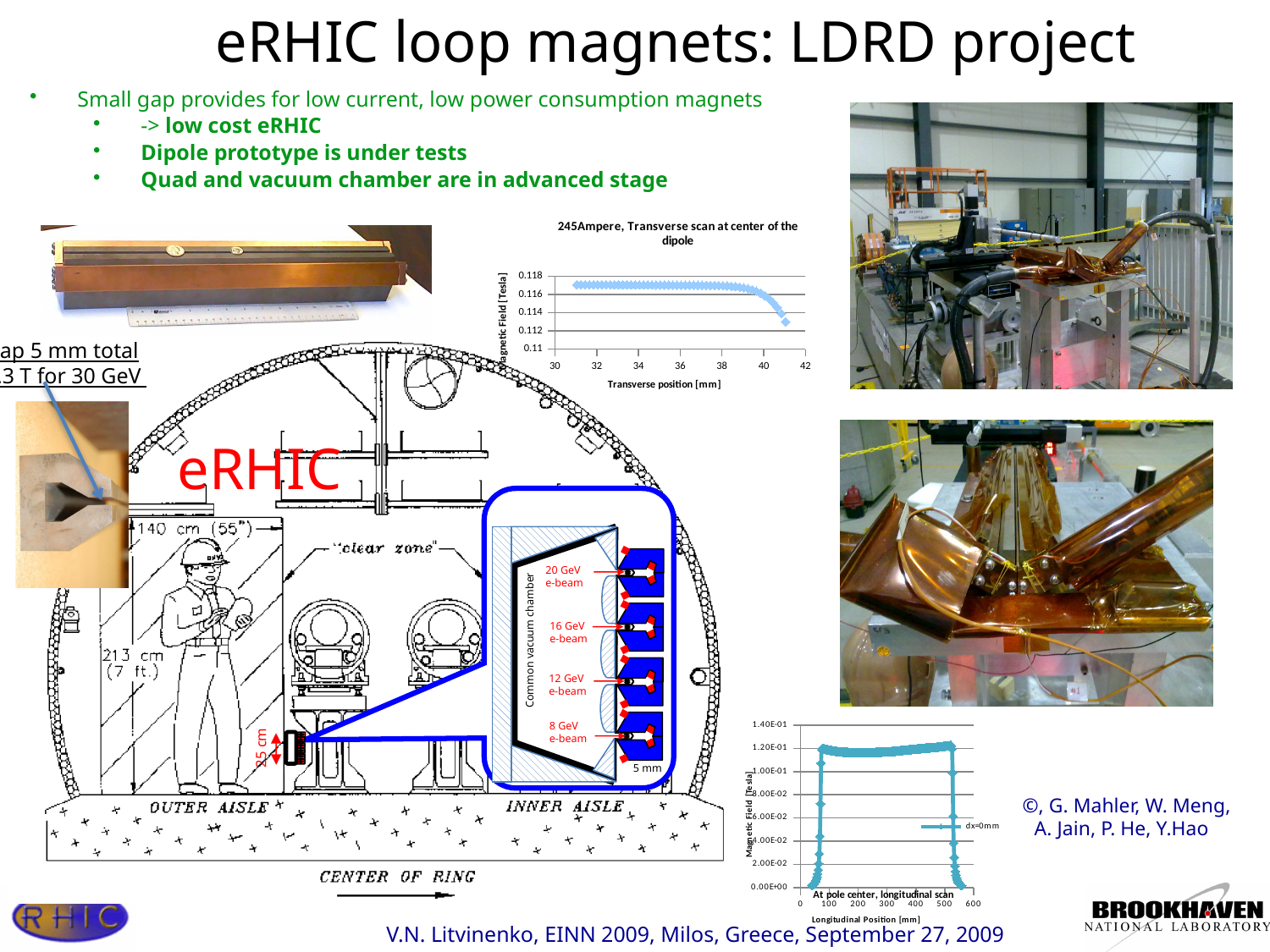
In the longitudinal scan chart at the bottom right of the slide, is the magnetic field at longitudinal position 300 mm greater or less than 1.40E-01 Tesla? less In the longitudinal scan chart at the bottom right of the slide, is the magnetic field at longitudinal position 300 mm greater or less than 1.00E-01 Tesla? greater In the longitudinal scan chart at the bottom right of the slide, what is the legend entry? dx=0mm In the chart titled '245Ampere, Transverse scan at center of the dipole', is the magnetic field larger at transverse position 34 mm or at 41 mm? 34 mm In the chart titled '245Ampere, Transverse scan at center of the dipole', does the magnetic field rise or fall as the transverse position approaches 42 mm? fall In the longitudinal scan chart at the bottom right of the slide, how many series does the legend list? 1 In the chart titled '245Ampere, Transverse scan at center of the dipole', what kind of chart is shown? scatter chart In the chart titled '245Ampere, Transverse scan at center of the dipole', is the magnetic field at transverse position 34 mm greater or less than 0.114 Tesla? greater What is the title of the chart in the top middle of the slide? 245Ampere, Transverse scan at center of the dipole In the chart titled '245Ampere, Transverse scan at center of the dipole', what is the label of the x axis? Transverse position [mm] In the longitudinal scan chart at the bottom right of the slide, what kind of chart is shown? line chart